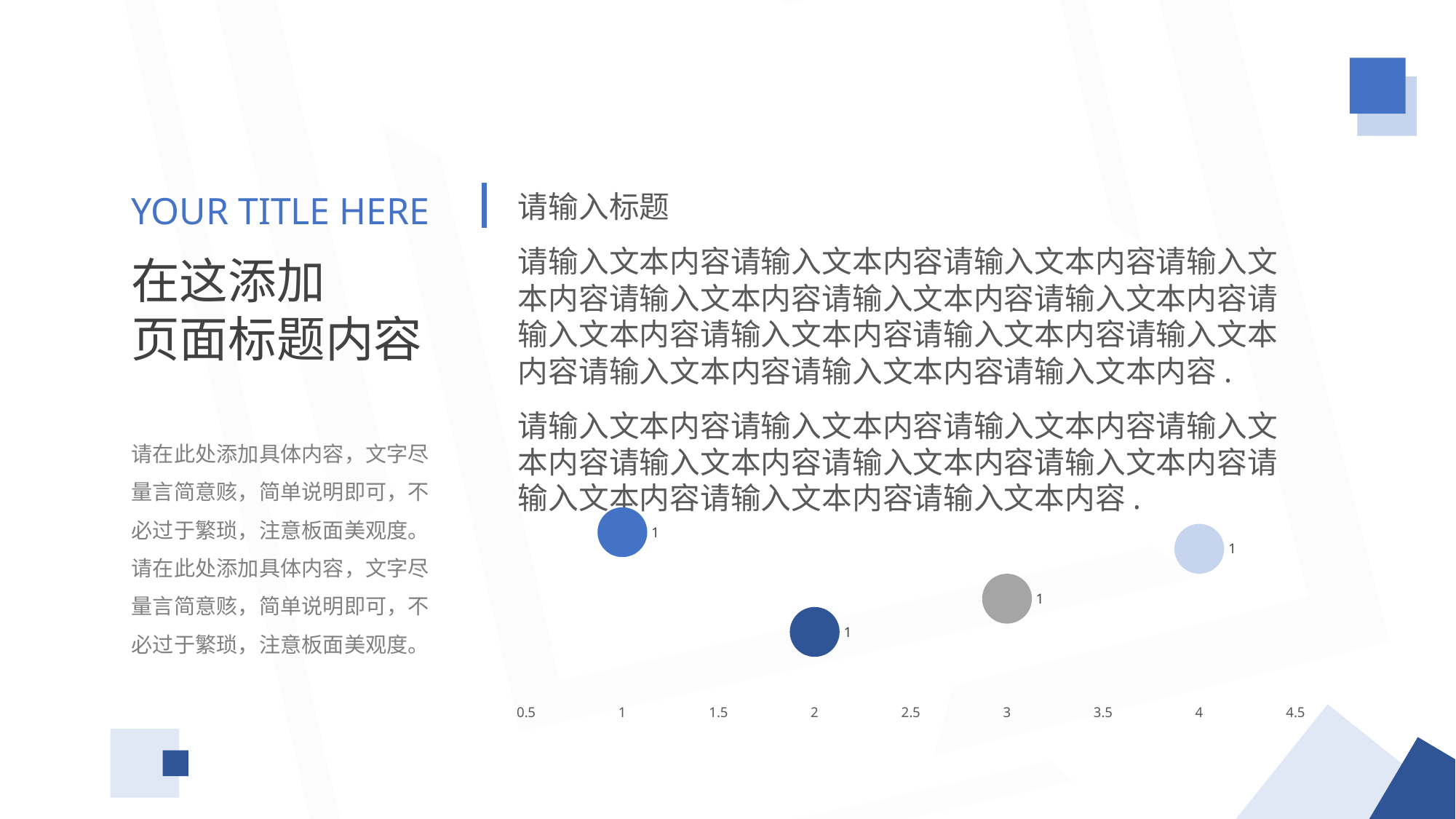
What data label is shown next to the gray bubble at x = 3? 1 What data label is shown next to the bubble at x = 4? 1 Is the bubble at x = 2 positioned higher or lower on the chart than the bubble at x = 3? lower What data label is shown next to the bubble at x = 1? 1 Does the chart display a legend? No What colour is the bubble at x = 3? gray What is the smallest tick value shown on the x axis? 0.5 What is the largest tick value shown on the x axis? 4.5 Which bubble sits lowest on the chart, the one at x = 1, x = 2, x = 3 or x = 4? x = 2 What kind of chart is shown on the slide? bubble chart What data label is shown next to the bubble at x = 2? 1 How many bubbles are plotted on the chart? 4